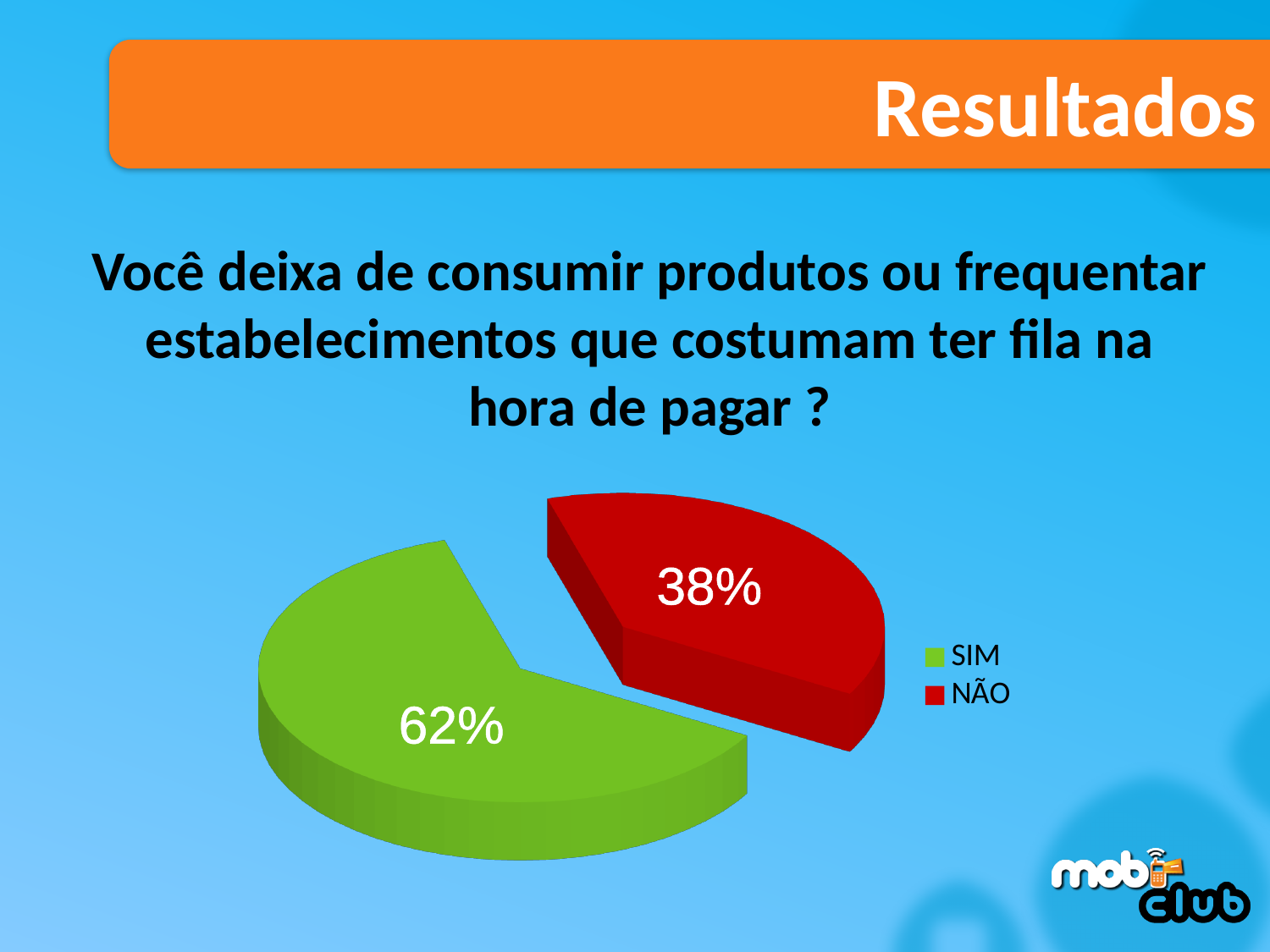
What share of the pie does the SIM slice represent? 62% How many slices does the pie chart have? 2 What percentage of respondents answered NÃO? 38% Which is larger, the share for SIM or the share for NÃO? SIM What colour is the SIM slice? Green What colour is the NÃO slice? Red What kind of chart is shown on the slide? Pie chart How many entries does the legend list? 2 Which response has the smallest share of the pie? NÃO What percentage of respondents answered SIM? 62% Which response has the largest share of the pie? SIM What is the difference in percentage points between SIM and NÃO? 24